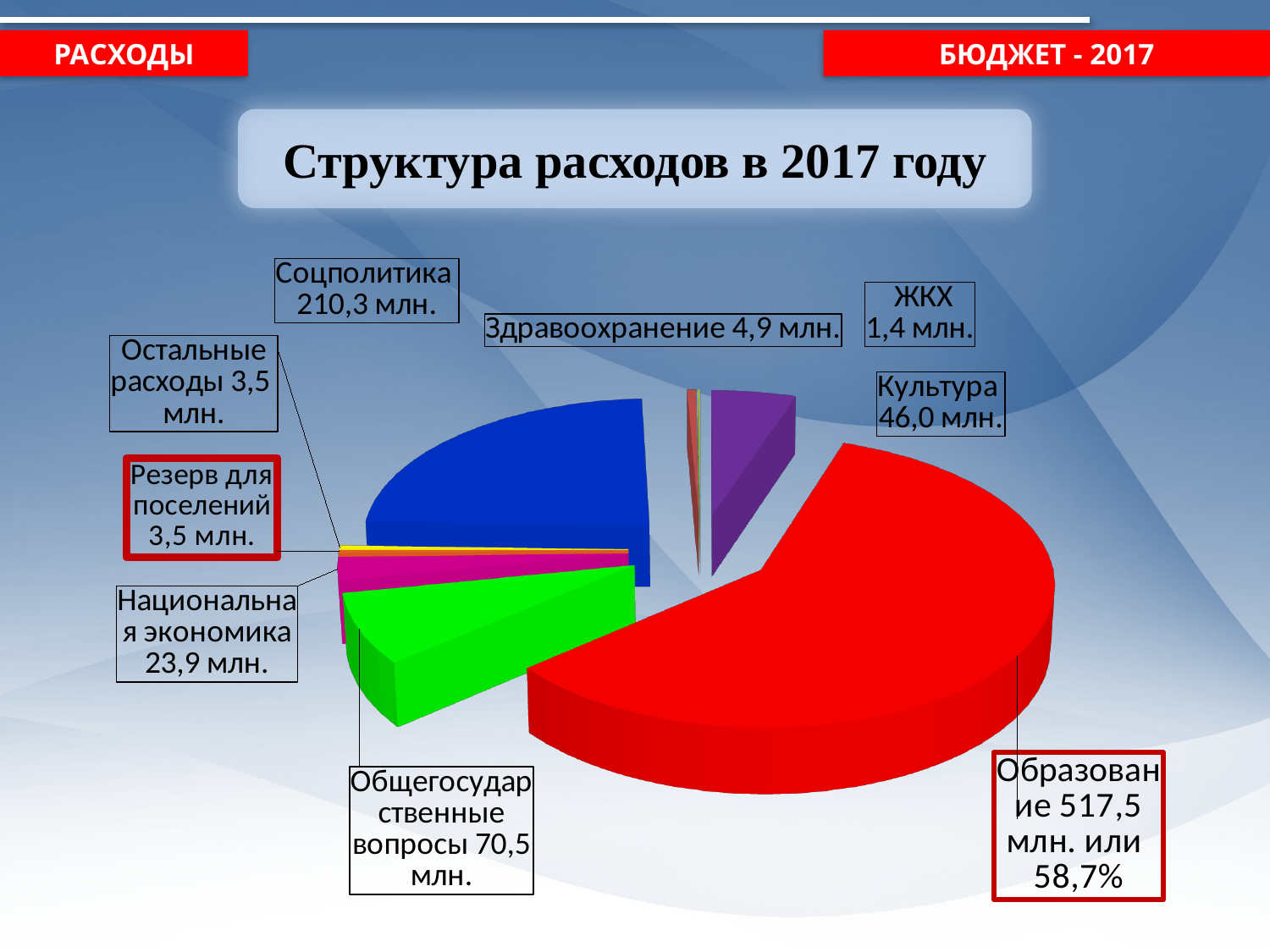
What is the value for Национальная экономика? 23,9 млн. What is the value for Культура? 46,0 млн. Which category has the largest share of expenses? Образование What share of the pie does Образование take? 58,7% Which category has the smallest value? ЖКХ What is the title of the chart? Структура расходов в 2017 году What kind of chart is shown on the slide? pie chart What is the value for Соцполитика? 210,3 млн. How many categories are shown in the pie chart? 9 What is the difference between Соцполитика and Культура? 164,3 млн. What is the value for Общегосударственные вопросы? 70,5 млн. Which is larger, Общегосударственные вопросы or Здравоохранение? Общегосударственные вопросы